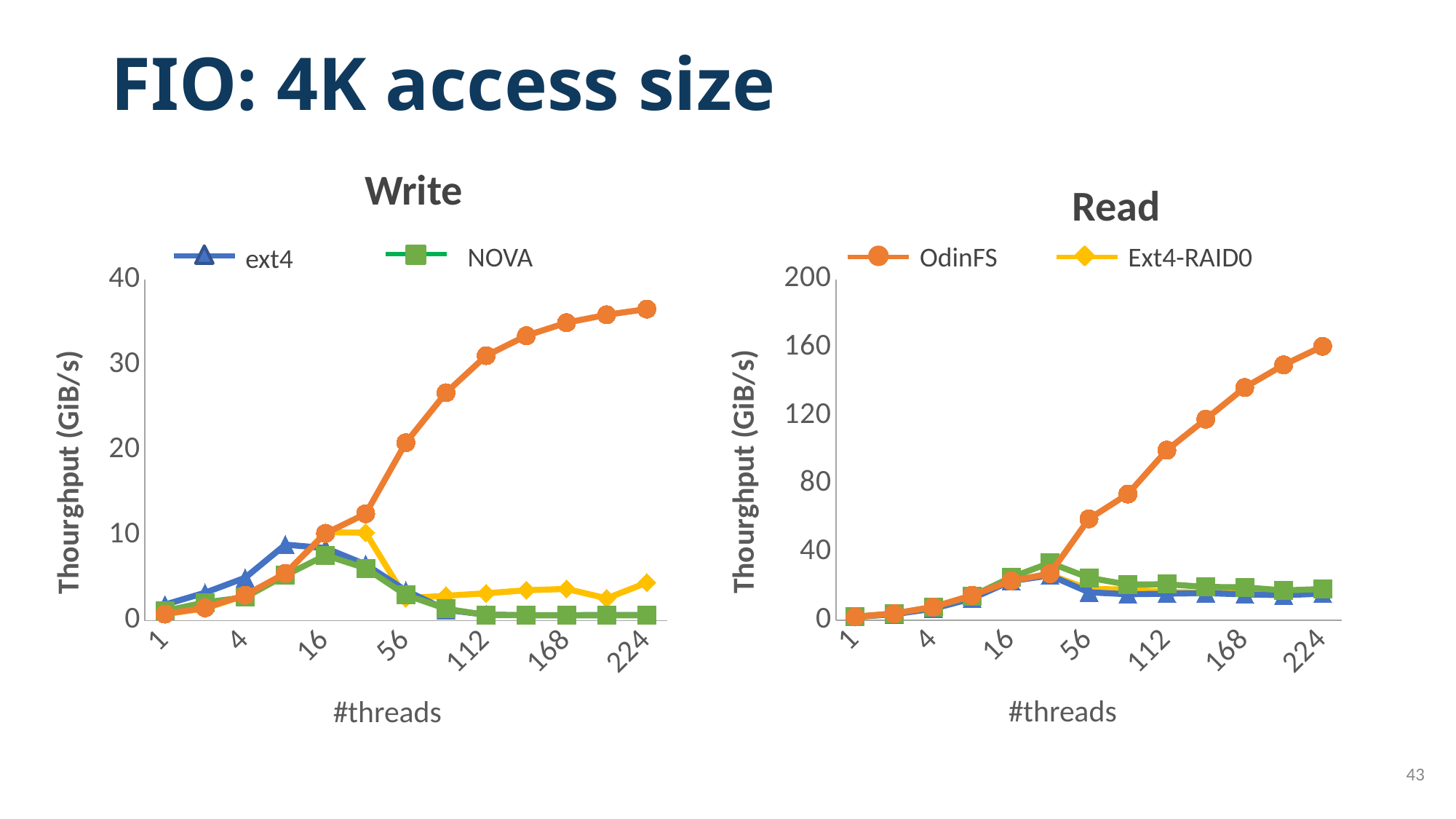
In the Read chart, is the ext4 value at 224 threads greater or less than 40? less What is the y-axis title of the Write chart? Thourghput (GiB/s) In the Read chart, which series has the highest throughput at 224 threads? OdinFS In the Write chart, which is larger at 224 threads: OdinFS or Ext4-RAID0? OdinFS In the Read chart, is the OdinFS value at 224 threads greater or less than 120? greater In the Write chart, which series has the highest throughput at 224 threads? OdinFS In the Read chart, does the OdinFS throughput rise or fall as the number of threads increases? rise How many thread-count labels are shown on the x axis of the Read chart? 7 In the Write chart, is the NOVA value at 224 threads greater or less than 10? less What kind of chart is the Write chart? line chart How many series does the legend list across the two charts? 4